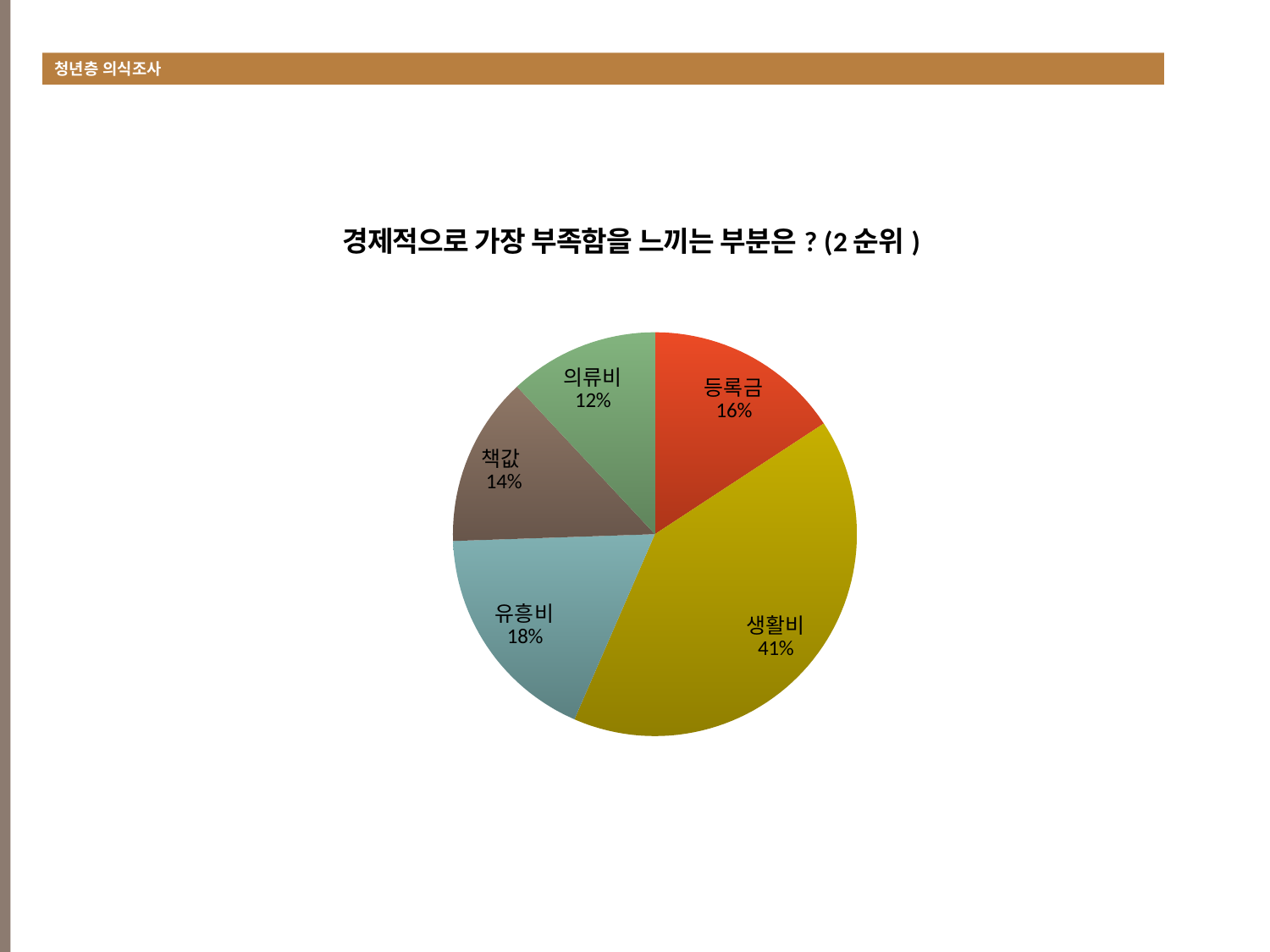
What is the value for 책값? 14% Which category has the largest share of the pie? 생활비 What is the title of the chart? 경제적으로 가장 부족함을 느끼는 부분은 ? (2 순위 ) What is the value for 유흥비? 18% What is the value for 의류비? 12% What is the value for 생활비? 41% Which category has the smallest share of the pie? 의류비 Which is larger, the value for 등록금 or the value for 책값? 등록금 What is the value for 등록금? 16% What is the difference between the values for 생활비 and 유흥비? 23% What kind of chart is shown on the slide? pie chart How many categories does the pie chart have? 5